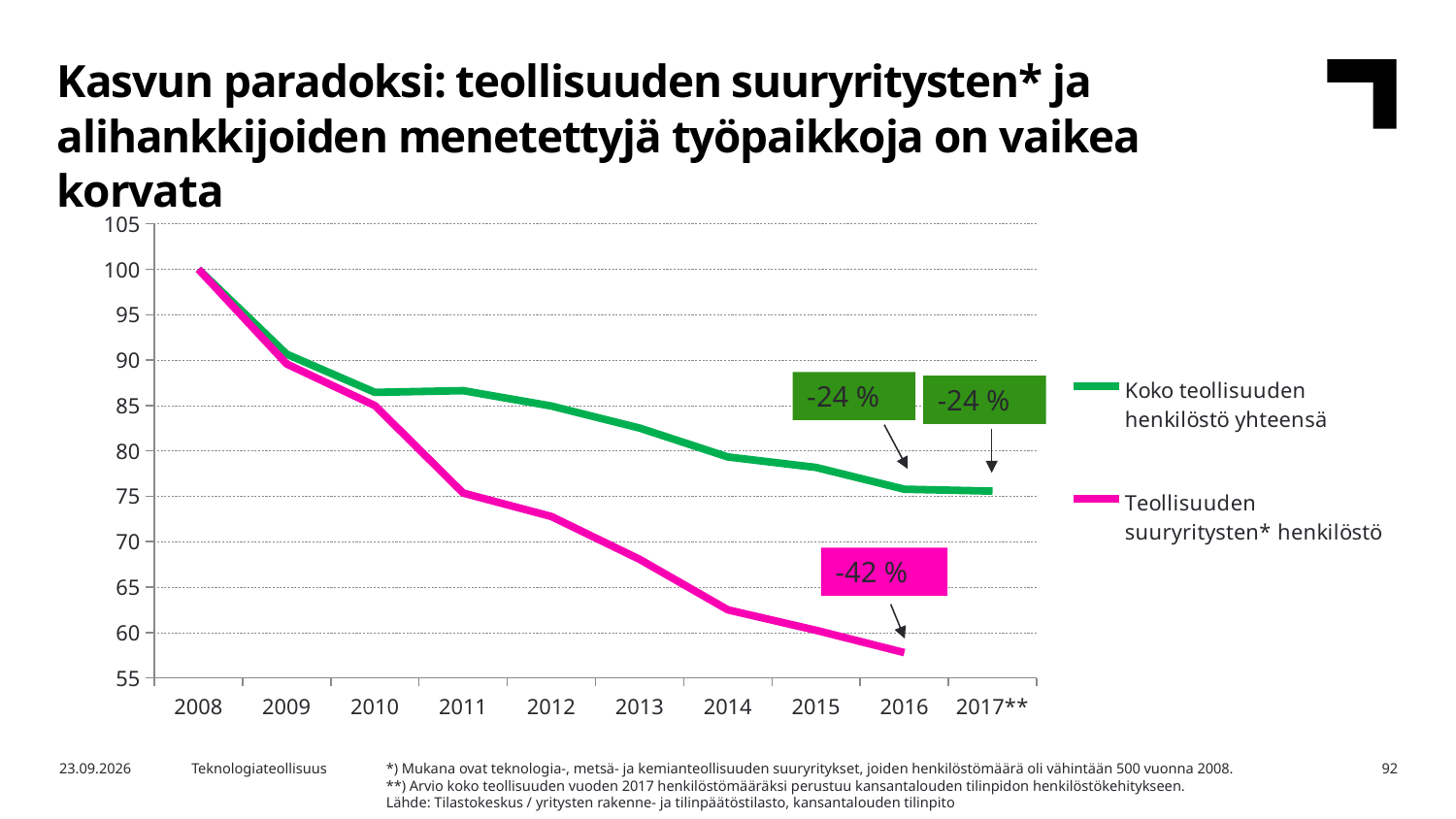
Is the value for Teollisuuden suuryritysten* henkilöstö in 2016 greater or less than 60? less Is the value for Teollisuuden suuryritysten* henkilöstö in 2012 greater or less than 75? less How many series does the legend list? 2 What is the value of both series in 2008? 100 In which year does the Teollisuuden suuryritysten* henkilöstö line reach its lowest value? 2016 In 2016, which series has the higher value: Koko teollisuuden henkilöstö yhteensä or Teollisuuden suuryritysten* henkilöstö? Koko teollisuuden henkilöstö yhteensä What kind of chart is shown on the slide? line chart What percentage change is labelled for the Koko teollisuuden henkilöstö yhteensä line at 2016? -24 % Do the values of the Teollisuuden suuryritysten* henkilöstö line rise or fall from 2008 to 2016? fall How many years are shown on the x axis? 10 What colour is the Koko teollisuuden henkilöstö yhteensä line? green What percentage change is labelled for the Teollisuuden suuryritysten* henkilöstö line at 2016? -42 %